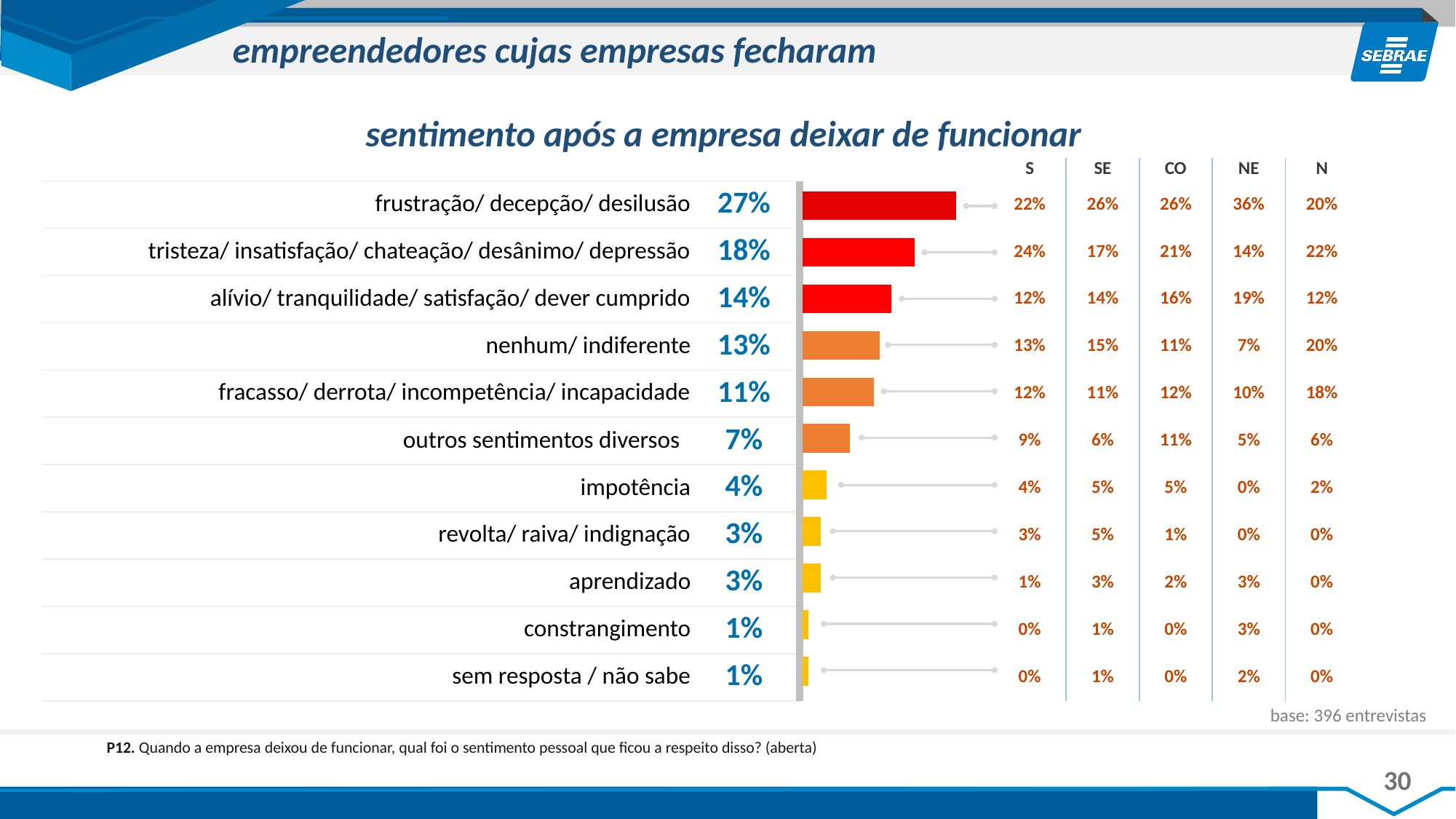
What is the title of the chart? sentimento após a empresa deixar de funcionar Which category has the highest value? frustração/ decepção/ desilusão What is the value for "nenhum/ indiferente"? 13% What is the difference between the values for "frustração/ decepção/ desilusão" and "tristeza/ insatisfação/ chateação/ desânimo/ depressão"? 9% What is the value for "frustração/ decepção/ desilusão"? 27% What is the value for "impotência"? 4% Which is larger, the value for "alívio/ tranquilidade/ satisfação/ dever cumprido" or the value for "fracasso/ derrota/ incompetência/ incapacidade"? alívio/ tranquilidade/ satisfação/ dever cumprido Do the values rise or fall going down the list of categories? fall How many categories are shown in the chart? 11 What is the value for "frustração/ decepção/ desilusão" in the NE column? 36% What is the value for "nenhum/ indiferente" in the N column? 20% What kind of chart is this? bar chart